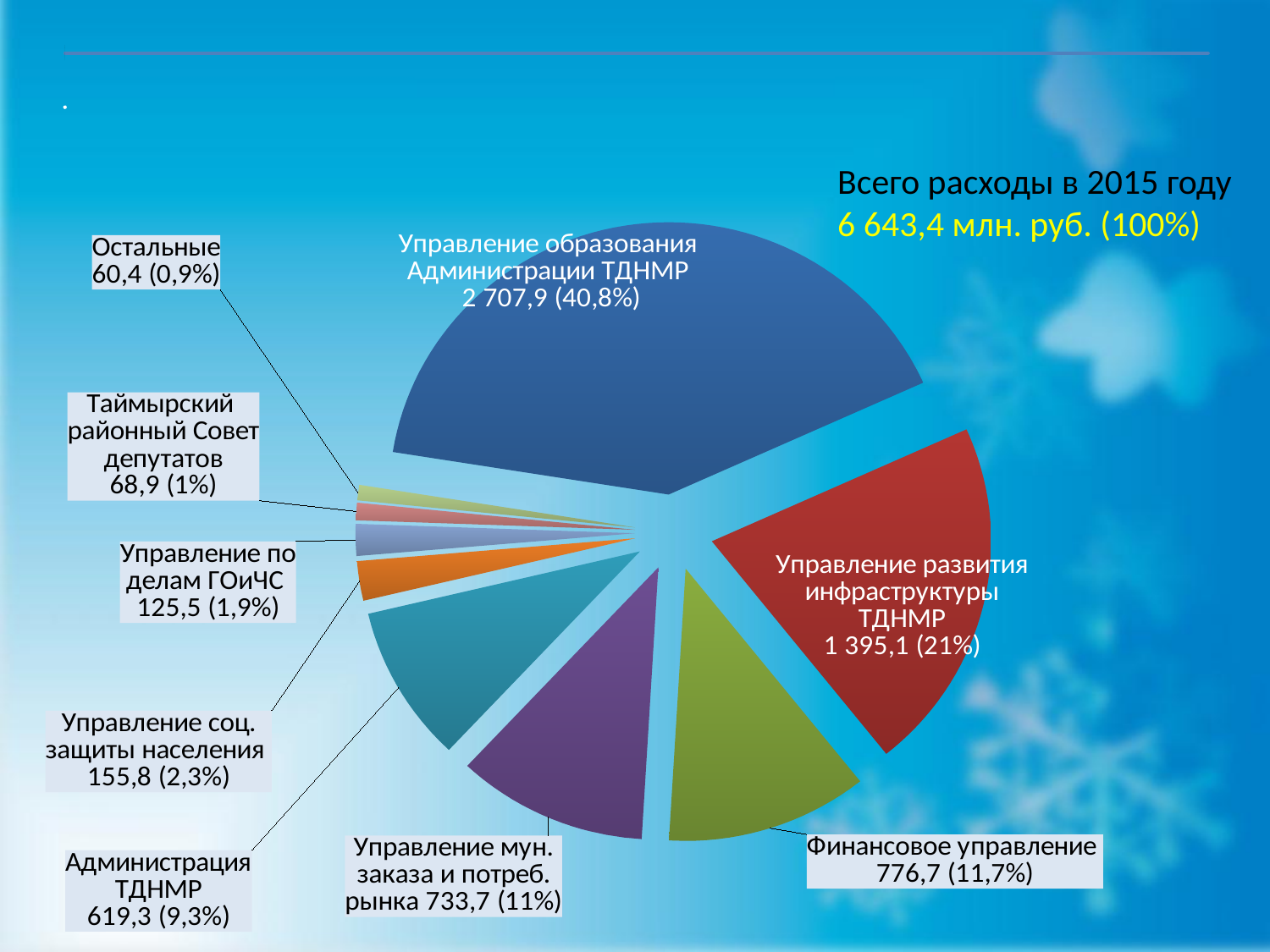
What is the value shown for Финансовое управление? 776,7 (11,7%) What kind of chart is shown on the slide? pie chart What share of the pie does Администрация ТДНМР account for? 9,3% How many slices does the pie chart have? 9 Which category has the largest slice of the pie? Управление образования Администрации ТДНМР Which category has the smallest slice of the pie? Остальные What is the difference between the values for Управление образования Администрации ТДНМР and Управление развития инфраструктуры ТДНМР? 1 312,8 What total expenditure for 2015 is stated on the slide? 6 643,4 млн. руб. (100%) What is the value shown for Управление по делам ГОиЧС? 125,5 (1,9%) Which is larger: Финансовое управление or Управление мун. заказа и потреб. рынка? Финансовое управление What share of the pie does Управление развития инфраструктуры ТДНМР account for? 21% What is the value shown for Управление образования Администрации ТДНМР? 2 707,9 (40,8%)